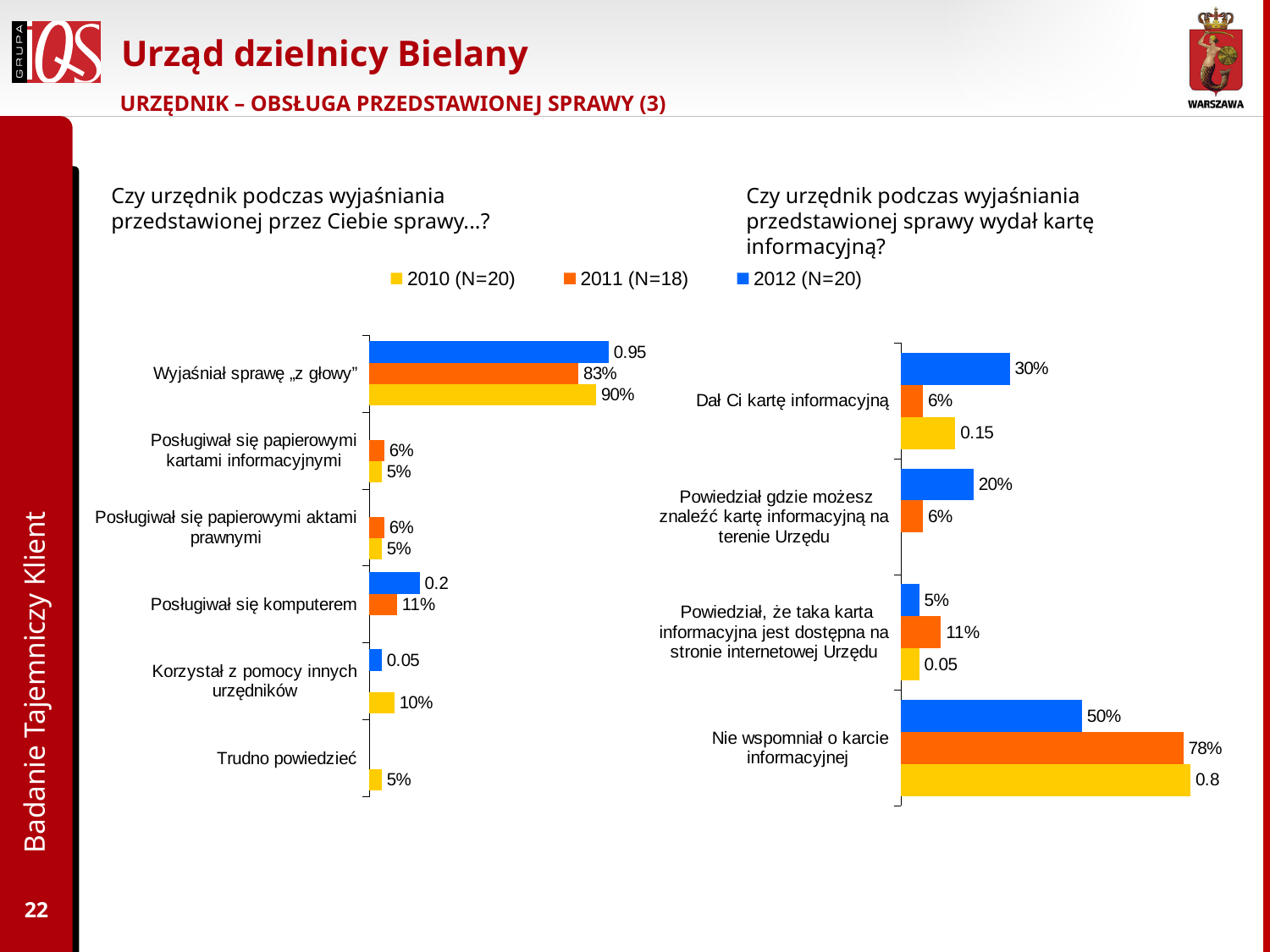
In the left chart, what is the 2011 (N=18) value for "Posługiwał się komputerem"? 11% In the left chart ("Czy urzędnik podczas wyjaśniania przedstawionej przez Ciebie sprawy...?"), what is the 2012 (N=20) value for "Wyjaśniał sprawę „z głowy”"? 0.95 In the right chart, what is the 2010 (N=20) value for "Nie wspomniał o karcie informacyjnej"? 0.8 In the right chart, what is the difference between the 2011 and 2012 values for "Nie wspomniał o karcie informacyjnej"? 28 percentage points In the left chart, what is the 2010 (N=20) value for "Korzystał z pomocy innych urzędników"? 10% How many series does the legend list? 3 In the left chart, how many categories are shown on the vertical axis? 6 In the left chart, what is the difference between the 2010 and 2011 values for "Wyjaśniał sprawę „z głowy”"? 7 percentage points In the right chart, which is larger for "Powiedział, że taka karta informacyjna jest dostępna na stronie internetowej Urzędu": the 2011 value or the 2012 value? 2011 In the right chart, which category has the highest 2011 (N=18) value? Nie wspomniał o karcie informacyjnej What type of chart is used on the right side of the slide? Bar chart In the right chart ("Czy urzędnik podczas wyjaśniania przedstawionej sprawy wydał kartę informacyjną?"), what is the 2012 (N=20) value for "Dał Ci kartę informacyjną"? 30%